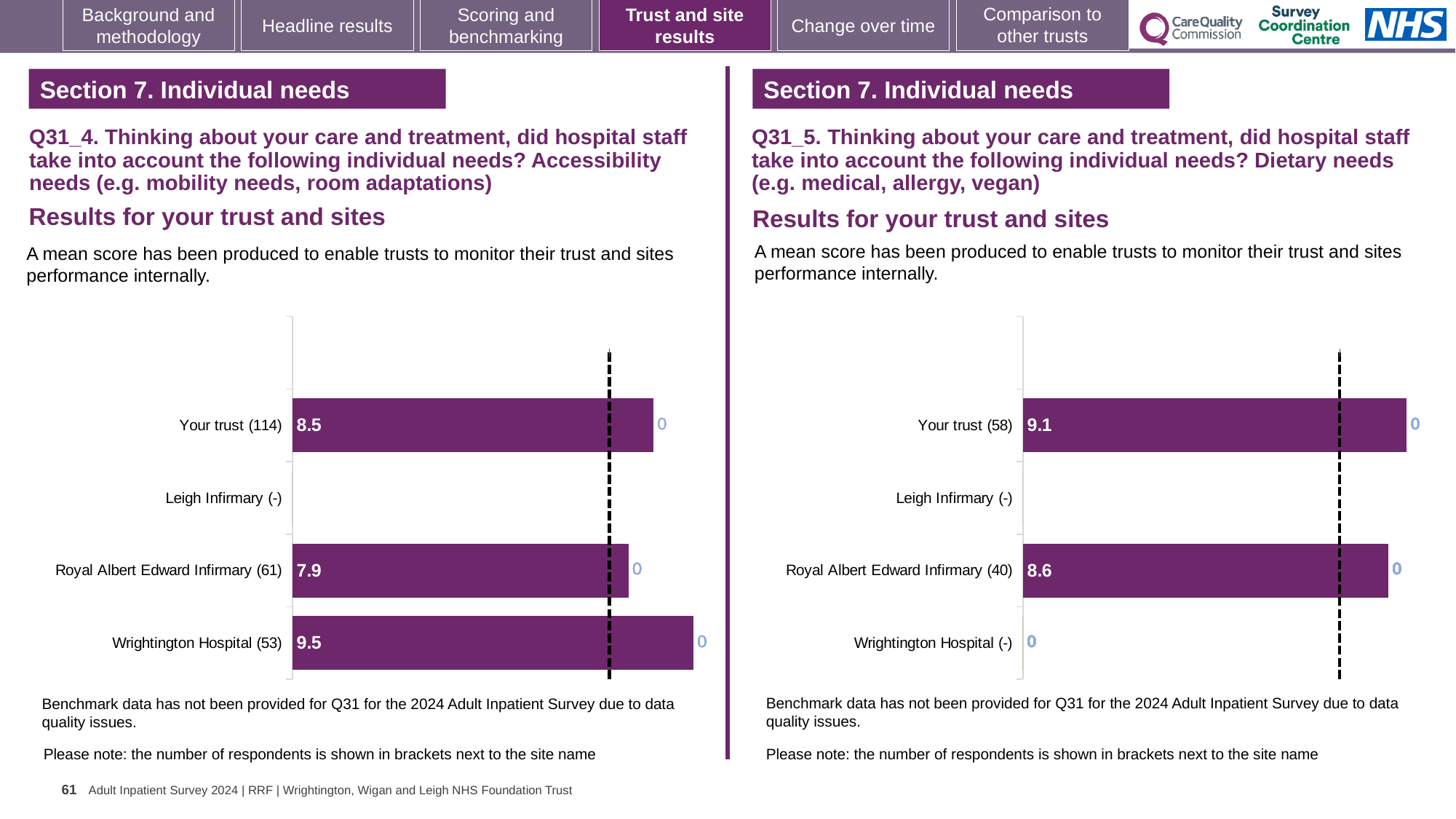
In the Q31_5 Dietary needs chart on the right, what is the mean score for Royal Albert Edward Infirmary (40)? 8.6 In the Q31_5 Dietary needs chart on the right, which is larger: the score for Your trust (58) or for Royal Albert Edward Infirmary (40)? Your trust (58) In the Q31_4 Accessibility needs chart on the left, how many categories are listed on the vertical axis? 4 In the Q31_4 Accessibility needs chart on the left, what is the mean score for Your trust (114)? 8.5 In the Q31_4 Accessibility needs chart on the left, what is the difference between the scores for Wrightington Hospital (53) and Royal Albert Edward Infirmary (61)? 1.6 In the Q31_4 Accessibility needs chart on the left, what is the mean score for Royal Albert Edward Infirmary (61)? 7.9 In the Q31_4 Accessibility needs chart on the left, which site has the highest mean score? Wrightington Hospital (53) In the Q31_5 Dietary needs chart on the right, what is the difference between the scores for Your trust (58) and Royal Albert Edward Infirmary (40)? 0.5 In the Q31_4 Accessibility needs chart on the left, what is the mean score for Wrightington Hospital (53)? 9.5 In the Q31_4 Accessibility needs chart on the left, which is larger: the score for Your trust (114) or for Royal Albert Edward Infirmary (61)? Your trust (114) What kind of chart is used in the Q31_5 Dietary needs chart on the right? Bar chart In the Q31_5 Dietary needs chart on the right, what is the mean score for Your trust (58)? 9.1